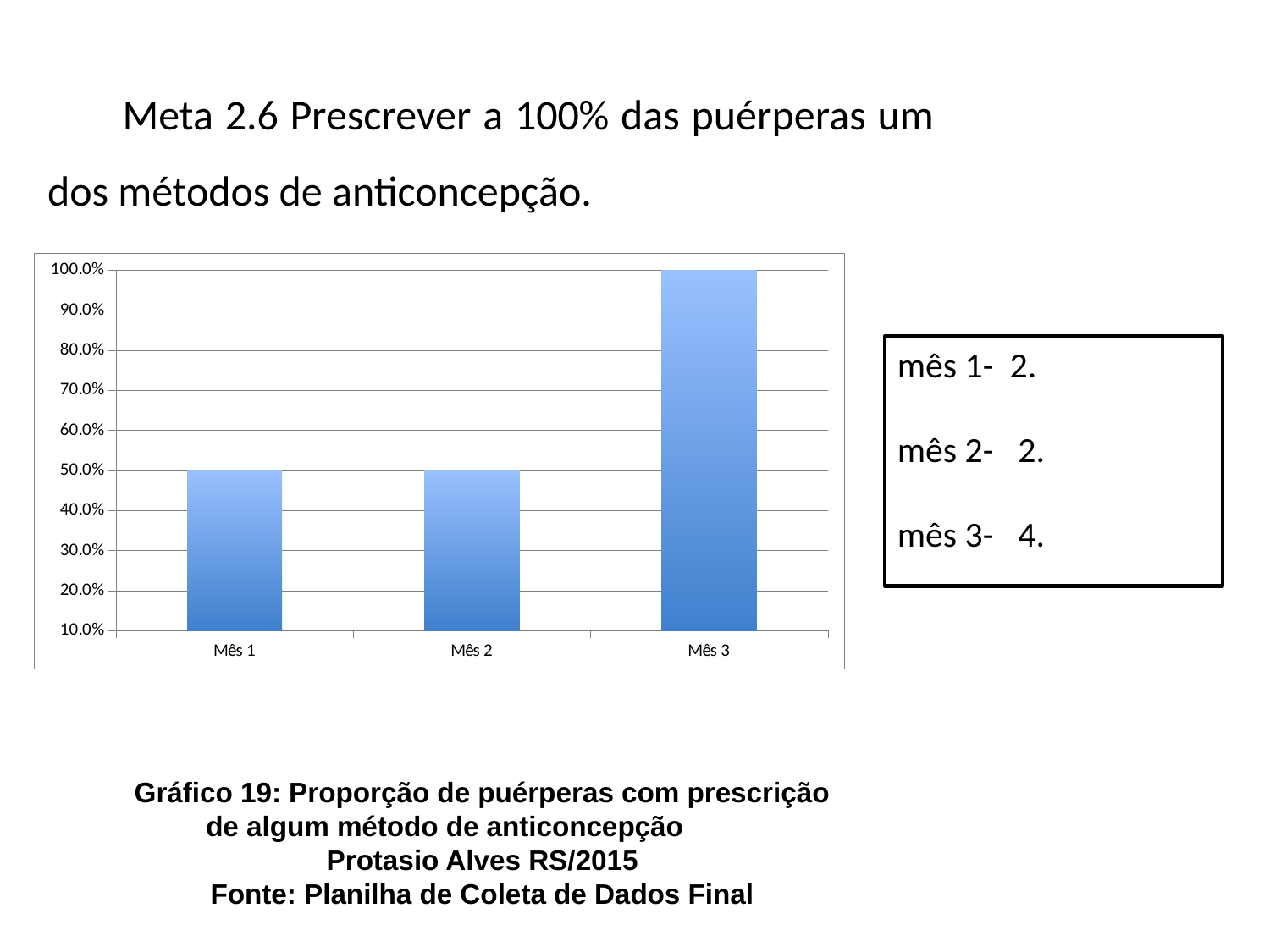
What kind of chart is shown on the slide? bar chart What is the lowest tick value shown on the y axis? 10.0% Is the value for Mês 3 greater or less than 90.0%? greater What is the value for Mês 3? 100.0% How many months are shown on the x axis? 3 Is the value for Mês 1 greater or less than 60.0%? less What is the value for Mês 2? 50.0% What is the value for Mês 1? 50.0% Which is larger, the value for Mês 3 or the value for Mês 2? Mês 3 Which month has the highest value? Mês 3 What is the difference between the values for Mês 3 and Mês 1? 50.0% Do the values rise or fall from Mês 1 to Mês 3? rise